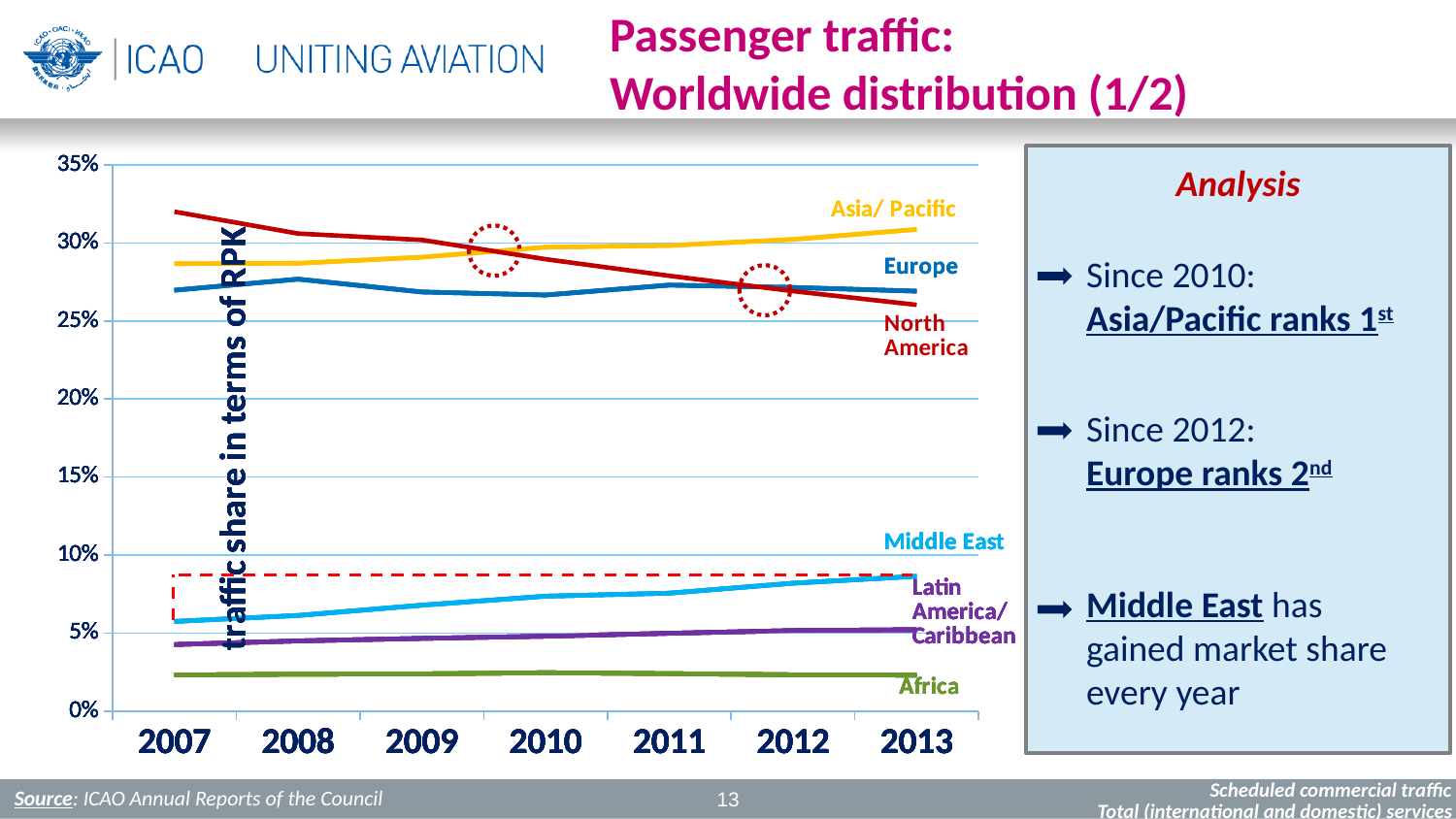
Is the value for Africa in 2013 greater or less than 5%? less How many years are shown along the x axis of the chart? 7 What kind of chart is shown on the slide? line chart Which region has the highest share in 2013? Asia/Pacific How many regions are plotted as lines on the chart? 6 Which region has the lowest share in 2013? Africa What is the label on the vertical axis of the chart? traffic share in terms of RPK In 2007, which has the larger share: North America or Asia/Pacific? North America Is the value for North America in 2007 greater or less than 30%? greater Does the North America line rise or fall from 2007 to 2013? fall Does the Middle East line rise or fall from 2007 to 2013? rise Does the Asia/Pacific line rise or fall from 2007 to 2013? rise